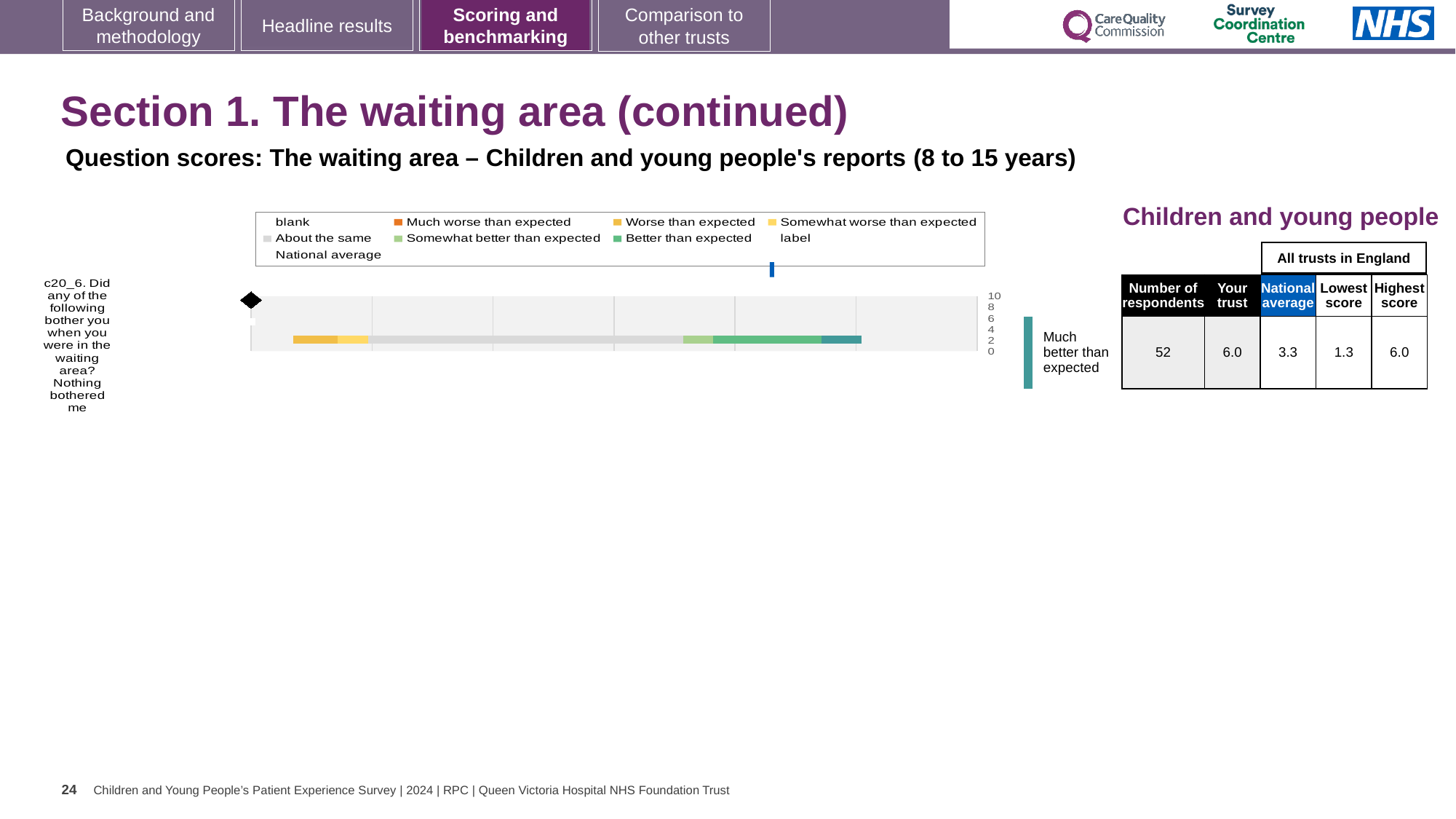
What is the lowest score among all trusts in England for question c20_6? 1.3 What kind of chart is shown on the slide? bar chart Which is larger for question c20_6: the 'Your trust' score or the national average? Your trust How many respondents answered question c20_6? 52 Which survey question is plotted in the chart? c20_6. Did any of the following bother you when you were in the waiting area? Nothing bothered me What is the 'Your trust' score for question c20_6 in the table? 6.0 What is the highest score among all trusts in England for question c20_6? 6.0 What is the difference between the 'Your trust' score and the national average for question c20_6? 2.7 What is the national average score for question c20_6 in the table? 3.3 How many survey questions (categories) are plotted in the chart? 1 What is the difference between the highest score and the lowest score among all trusts in England for question c20_6? 4.7 What benchmark rating label is shown next to the chart for question c20_6? Much better than expected